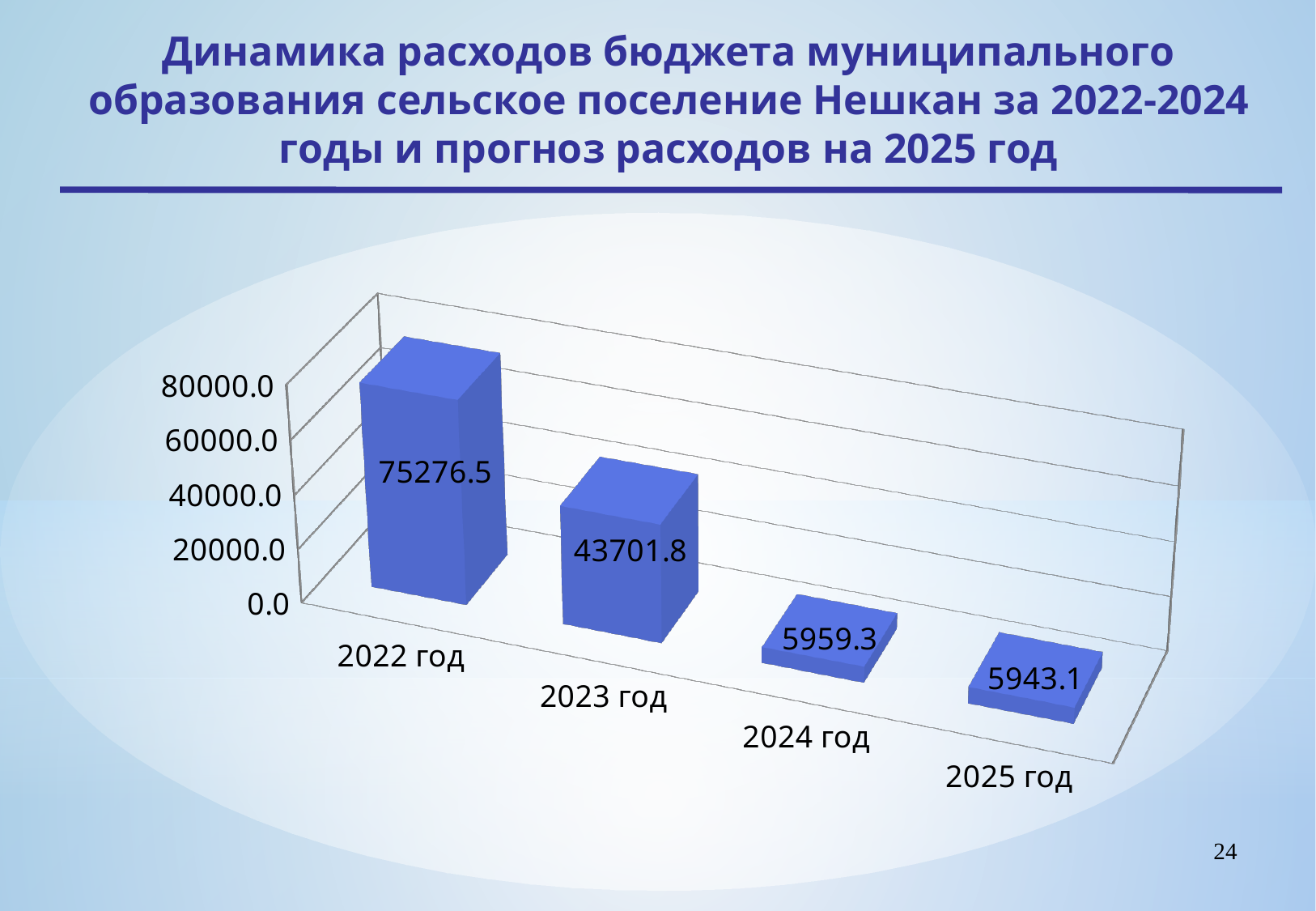
What is the difference between the values for 2024 год and 2025 год? 16.2 What is the value for 2023 год? 43701.8 Is the value for 2022 год greater or less than 60000.0? greater Which is larger, the value for 2024 год or the value for 2025 год? 2024 год What is the value for 2024 год? 5959.3 How many years are shown on the chart? 4 What is the value for 2022 год? 75276.5 What is the value for 2025 год? 5943.1 Which year has the highest value? 2022 год Which year has the lowest value? 2025 год What is the difference between the values for 2022 год and 2023 год? 31574.7 What kind of chart is shown on the slide? bar chart